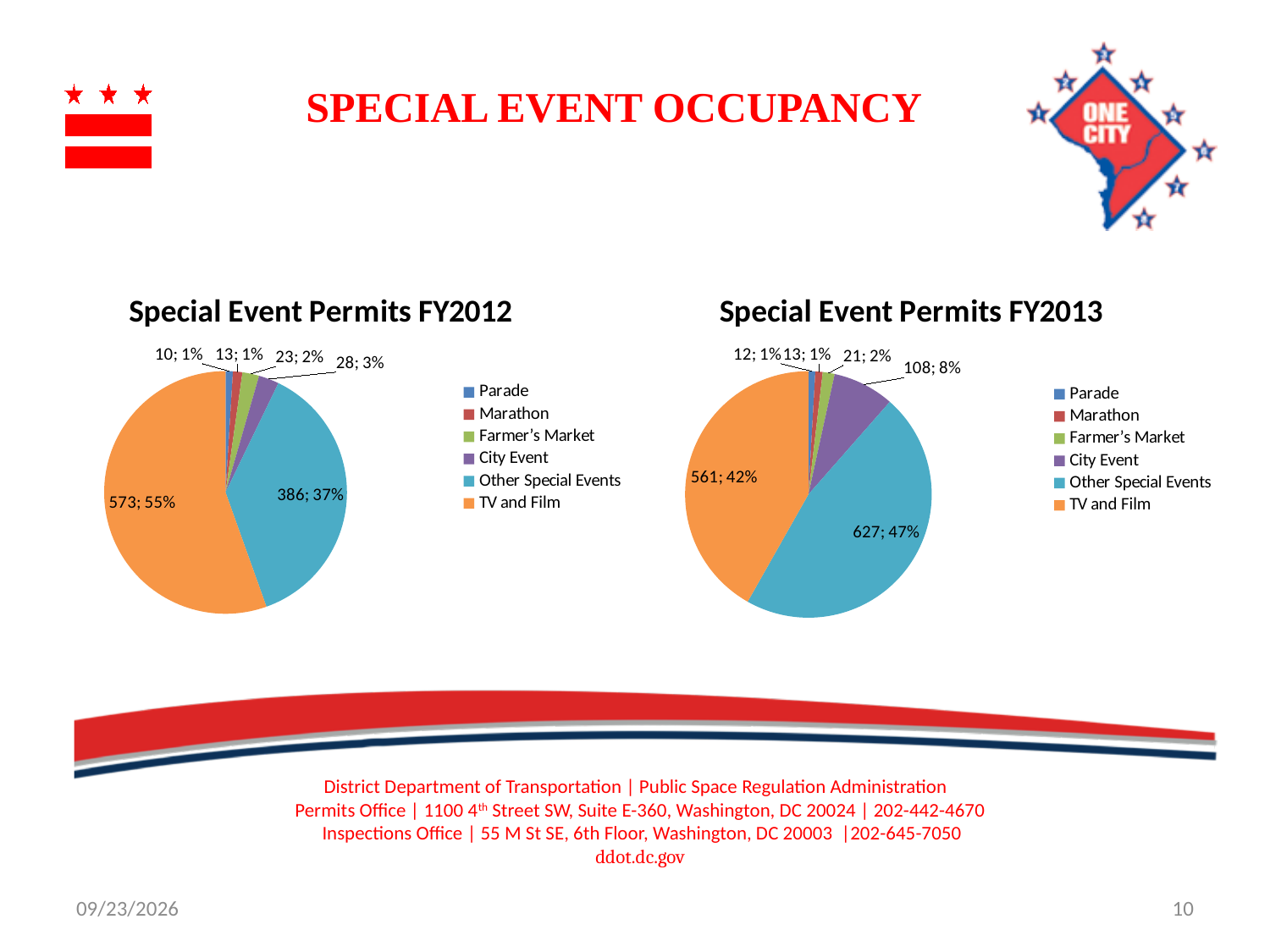
In the Special Event Permits FY2013 chart, what value is shown for City Event? 108; 8% How many categories does the legend of the Special Event Permits FY2012 chart list? 6 In the Special Event Permits FY2012 chart, what share of the pie does Other Special Events represent? 37% In the Special Event Permits FY2013 chart, what value is shown for Other Special Events? 627; 47% In the Special Event Permits FY2013 chart, which category has the largest slice? Other Special Events In the Special Event Permits FY2013 chart, which is larger, Other Special Events or TV and Film? Other Special Events In the Special Event Permits FY2012 chart, what is the difference between the TV and Film count and the Other Special Events count? 187 In the Special Event Permits FY2012 chart, which category has the largest slice? TV and Film In the Special Event Permits FY2012 chart, what value is shown for TV and Film? 573; 55% In the Special Event Permits FY2013 chart, what share of the pie does TV and Film represent? 42% In the Special Event Permits FY2012 chart, what colour is the TV and Film slice? Orange What type of chart is the Special Event Permits FY2013 chart? Pie chart